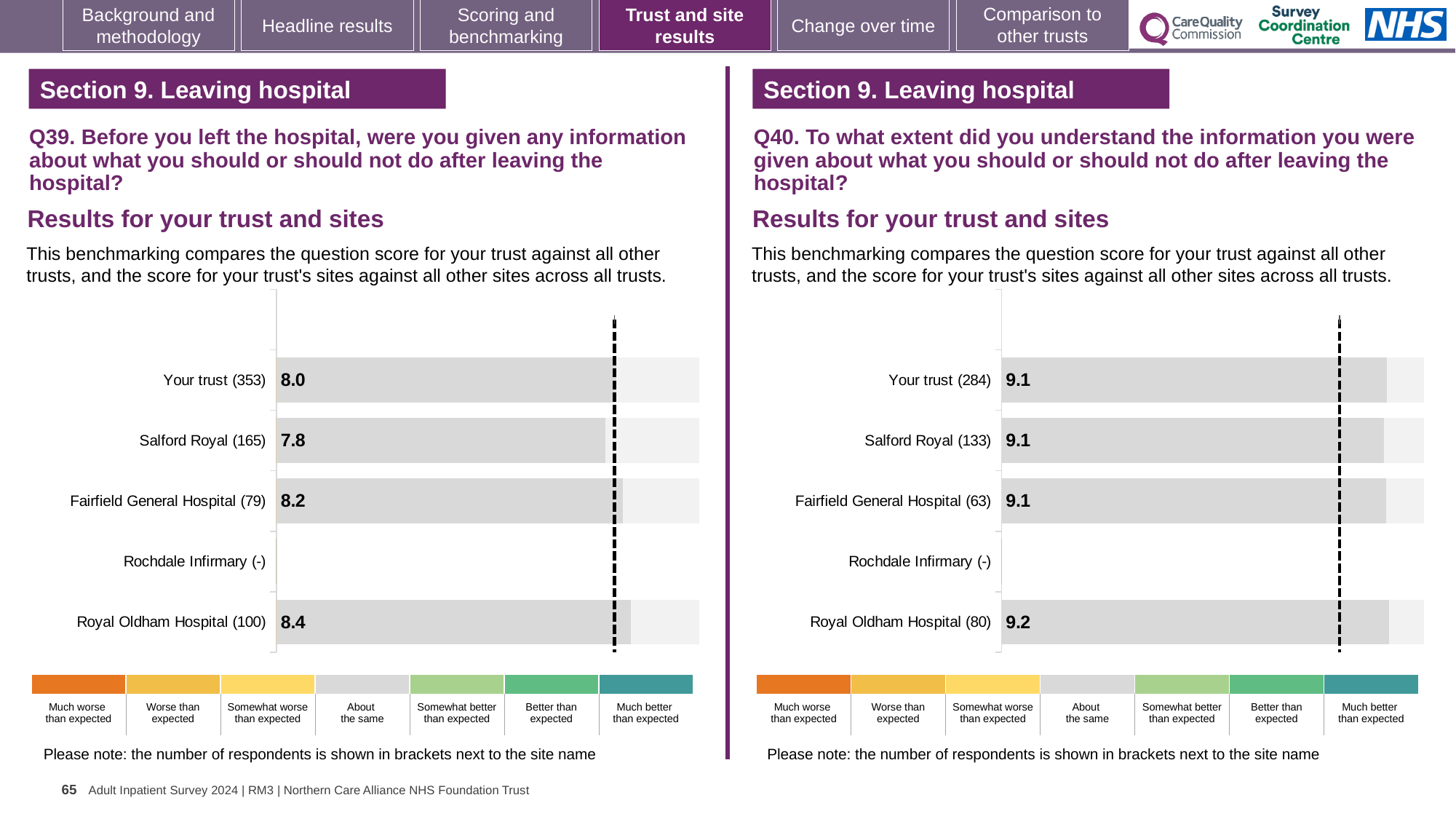
In the Q40 chart on the right, what is the score for Fairfield General Hospital (63)? 9.1 In the Q39 chart on the left, what is the score for Your trust (353)? 8.0 How many categories (rows) are listed in the Q39 chart on the left? 5 In the Q40 chart on the right, what is the difference between the scores for Royal Oldham Hospital (80) and Your trust (284)? 0.1 In the Q39 chart on the left, what is the difference between the scores for Royal Oldham Hospital (100) and Salford Royal (165)? 0.6 What kind of chart is used for the Q40 results on the right? Bar chart In the Q39 chart on the left, which site has the lowest score? Salford Royal (165) In the Q39 chart on the left, which site has the highest score? Royal Oldham Hospital (100) In the Q39 chart on the left, which has the higher score: Fairfield General Hospital (79) or Your trust (353)? Fairfield General Hospital (79) In the Q39 chart on the left, what is the score for Salford Royal (165)? 7.8 In the Q40 chart on the right, which site has the highest score? Royal Oldham Hospital (80) In the Q40 chart on the right, what is the score for Royal Oldham Hospital (80)? 9.2